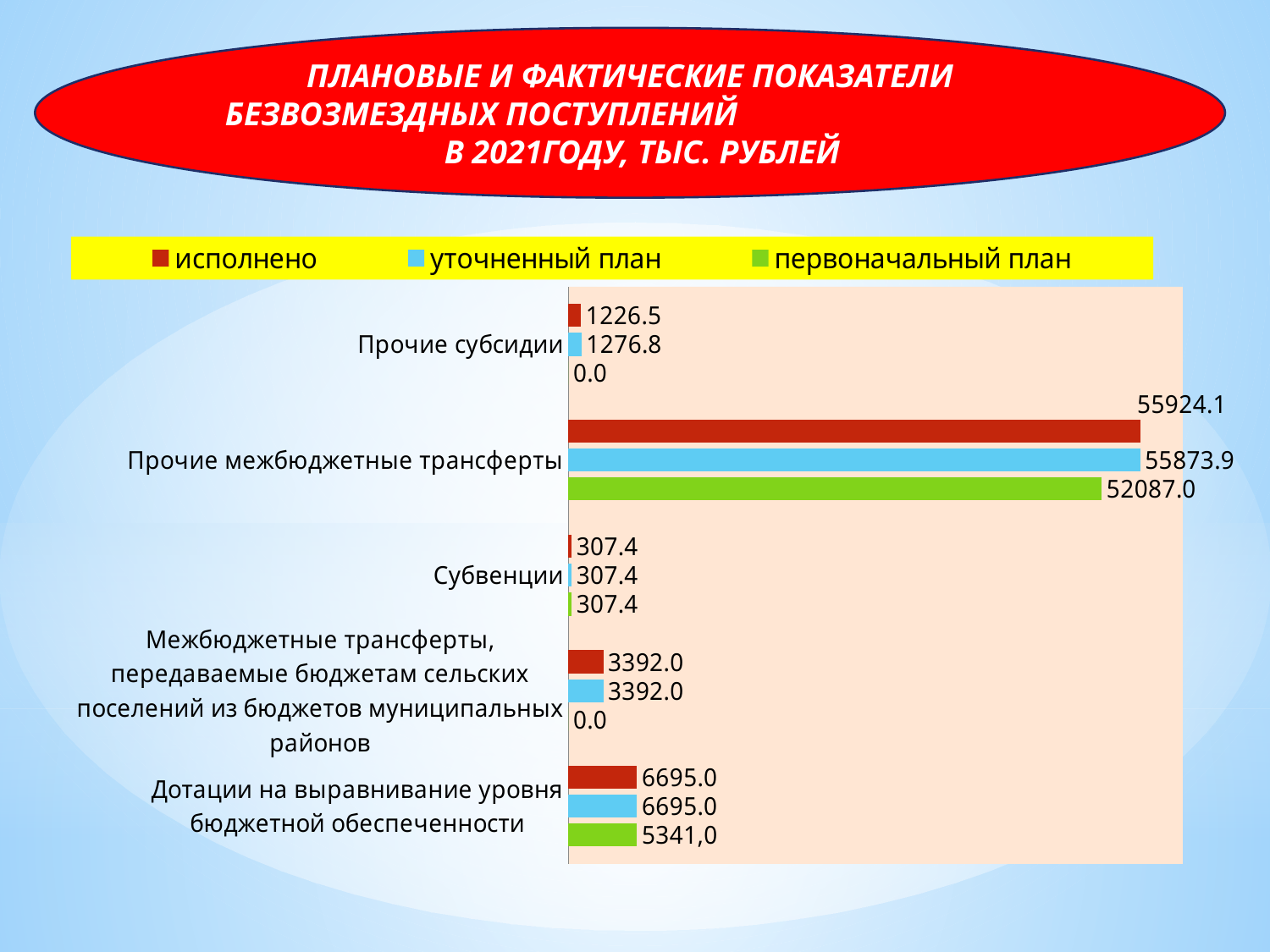
What is the value of 'первоначальный план' for 'Прочие межбюджетные трансферты'? 52087.0 What is the value of 'первоначальный план' for 'Дотации на выравнивание уровня бюджетной обеспеченности'? 5341,0 How many series does the legend list? 3 What is the value of 'исполнено' for 'Прочие межбюджетные трансферты'? 55924.1 What is the difference between 'исполнено' and 'первоначальный план' for 'Прочие межбюджетные трансферты'? 3837.1 What is the value of 'уточненный план' for 'Прочие субсидии'? 1276.8 How many categories are shown on the chart? 5 Which category has the highest 'исполнено' value? Прочие межбюджетные трансферты Which category has the lowest 'уточненный план' value? Субвенции What type of chart is shown on the slide? bar chart Which is larger for 'Прочие субсидии': 'исполнено' or 'уточненный план'? уточненный план Which colour represents the 'первоначальный план' series in the legend? green